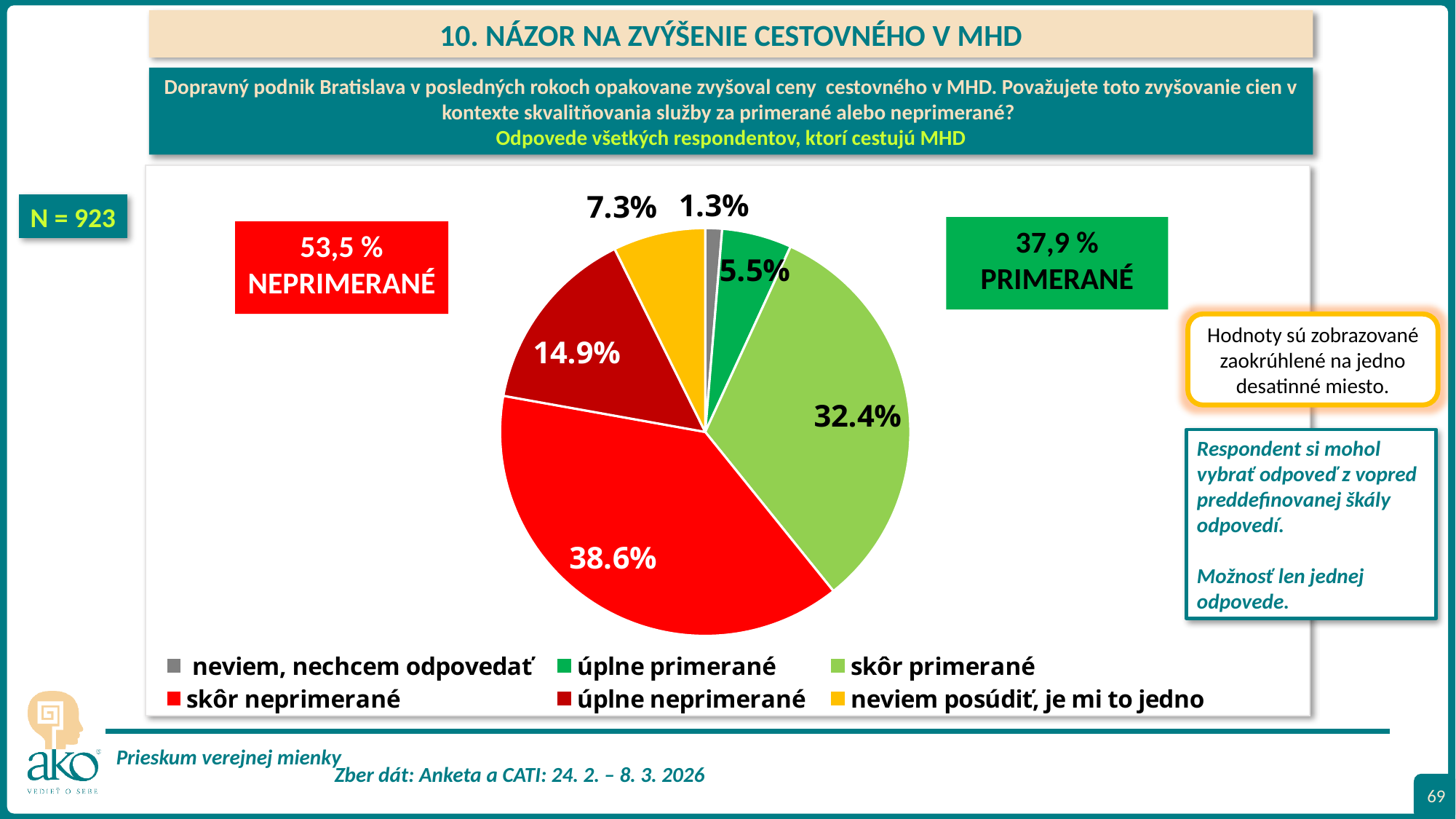
How many answer categories does the pie chart show? 6 Which answer category has the smallest share of the pie? neviem, nechcem odpovedať What percentage of respondents answered "úplne primerané"? 5.5% What percentage of respondents answered "úplne neprimerané"? 14.9% What percentage of respondents answered "skôr neprimerané"? 38.6% Which answer category has the largest share of the pie? skôr neprimerané What percentage of respondents answered "skôr primerané"? 32.4% Which is larger: the share for "úplne neprimerané" or the share for "neviem posúdiť, je mi to jedno"? úplne neprimerané What is the difference in percentage points between "skôr neprimerané" and "skôr primerané"? 6.2 What kind of chart is shown on the slide? pie chart What percentage of respondents answered "neviem posúdiť, je mi to jedno"? 7.3% What colour is the slice for "neviem posúdiť, je mi to jedno"? yellow